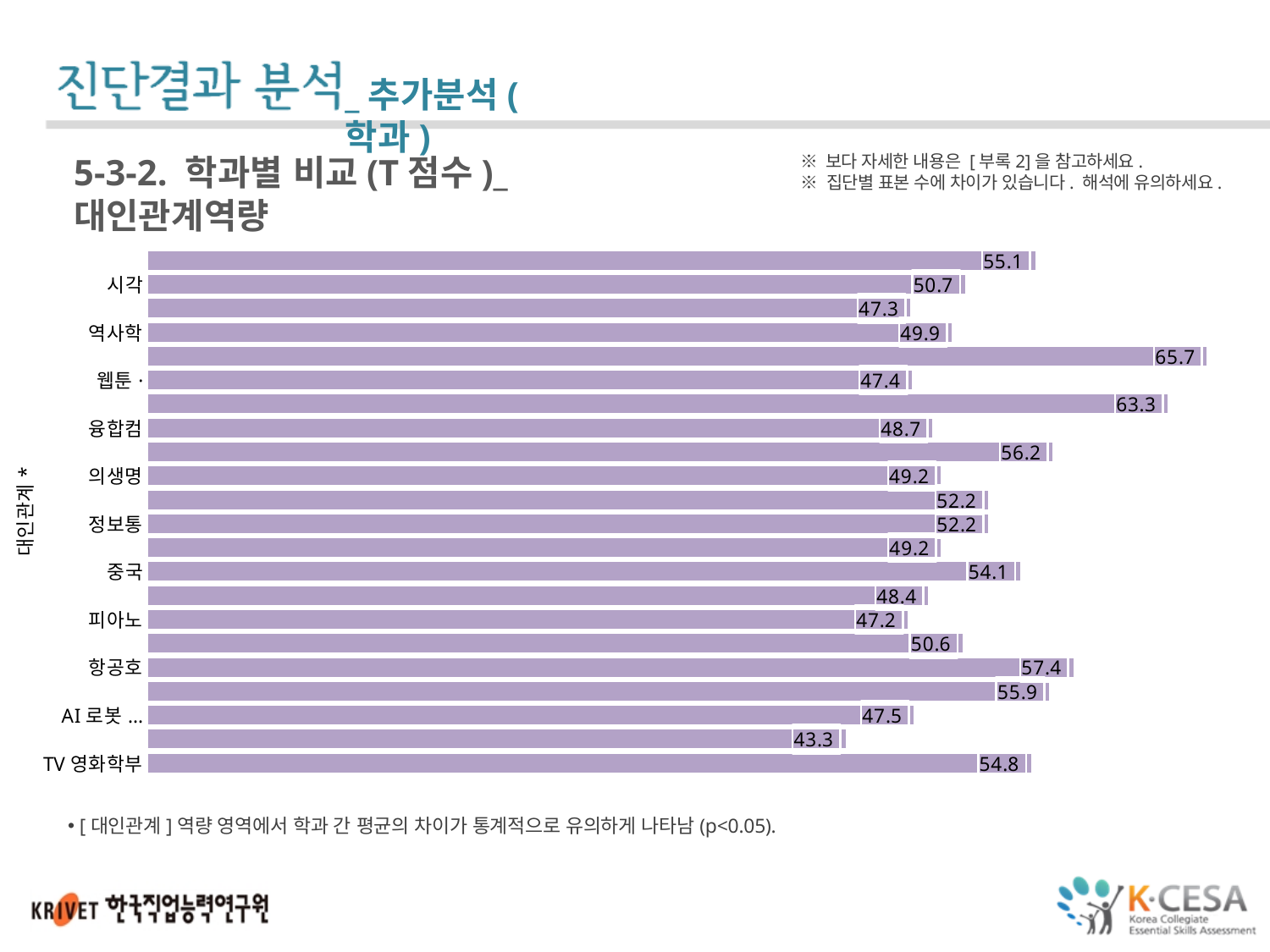
What is the difference between the values for TV 영화학부 and 융합컴? 6.1 What is the value for TV 영화학부? 54.8 What is the value for 항공호? 57.4 What is the value for 피아노? 47.2 What is the value for 시각? 50.7 What is the difference between the values for 항공호 and 중국? 3.3 Which has a larger value, 정보통 or 의생명? 정보통 What is the highest value shown on the chart? 65.7 How many bars are plotted on the chart? 22 What is the value for 역사학? 49.9 What is the lowest value shown on the chart? 43.3 What type of chart is shown on the slide? bar chart